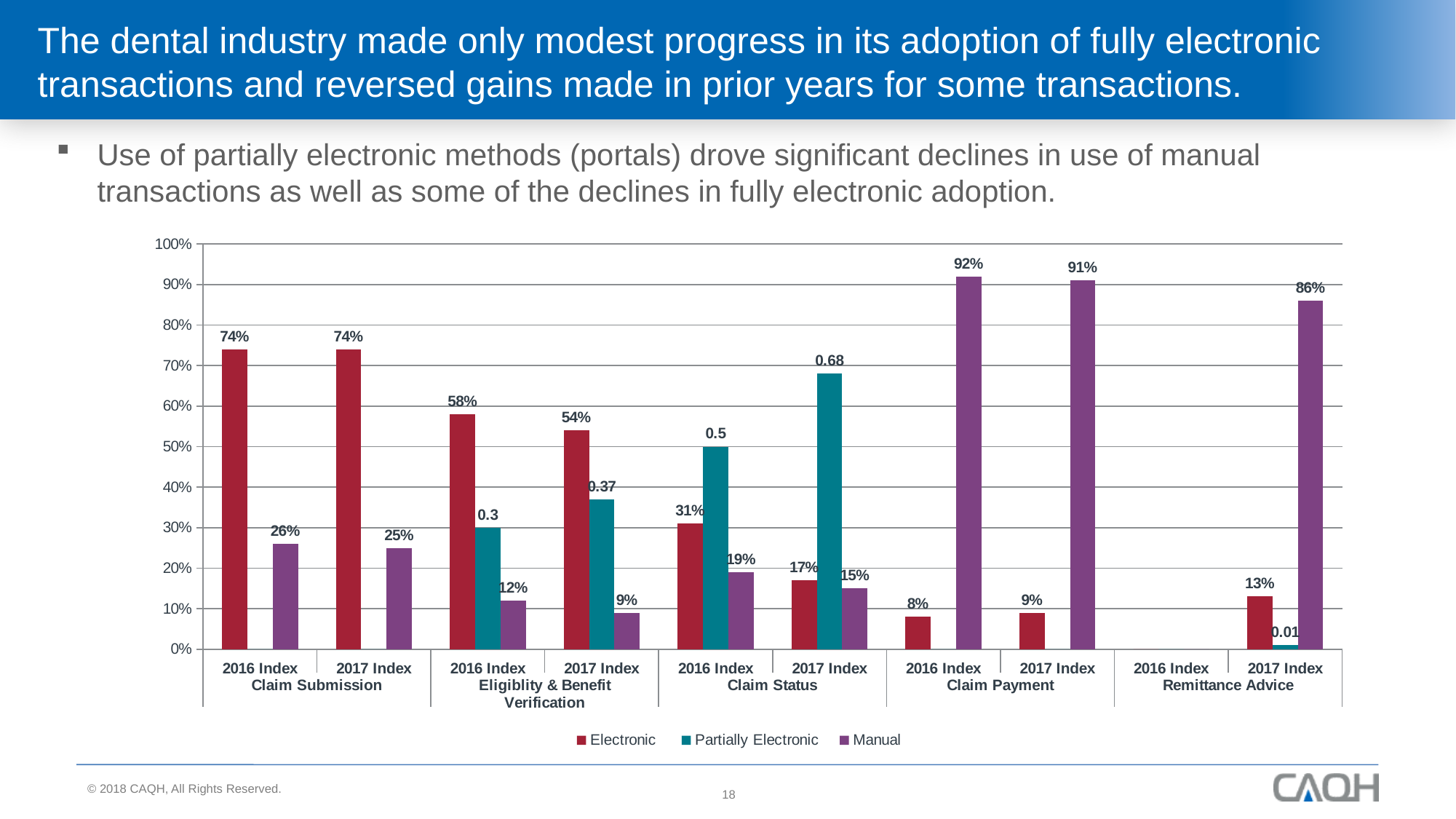
What is the Partially Electronic value for the 2017 Index under Claim Status? 0.68 How many series does the legend list? 3 What is the Electronic value for the 2017 Index under Claim Payment? 9% What is the difference between the Electronic values for the 2016 Index and 2017 Index under Claim Status? 14% What is the Electronic value for the 2016 Index under Claim Submission? 74% What kind of chart is shown on the slide? Bar chart What is the Manual value for the 2016 Index under Claim Payment? 92% Which bar has the highest Manual value? 2016 Index, Claim Payment (92%) What is the difference between the Manual values for the 2016 Index and 2017 Index under Eligiblity & Benefit Verification? 3% Under Eligiblity & Benefit Verification, which has the larger Electronic value, the 2016 Index or the 2017 Index? 2016 Index Which bar has the lowest Electronic value? 2016 Index, Claim Payment (8%) What is the Manual value for the 2017 Index under Remittance Advice? 86%